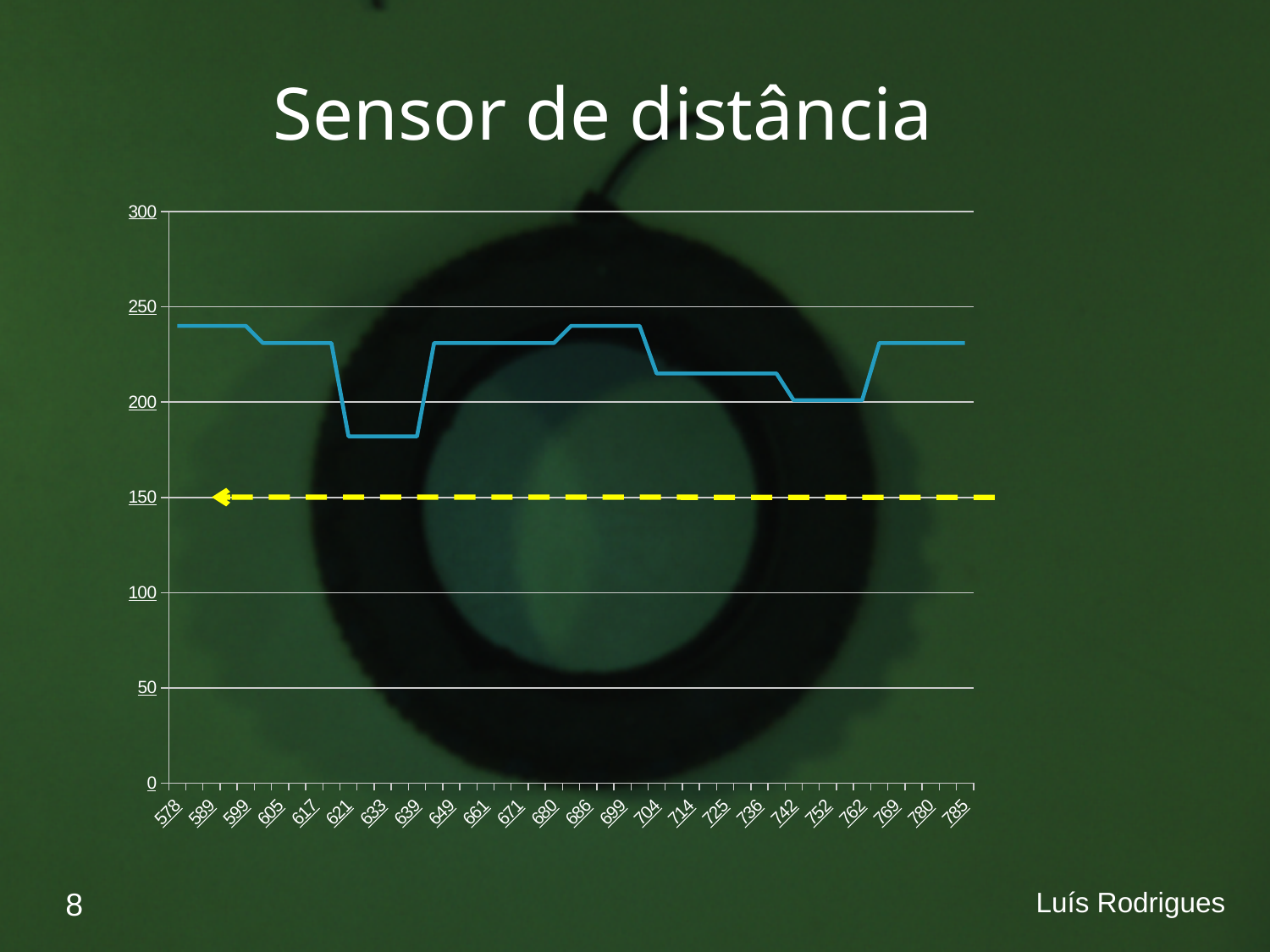
At what value on the y axis is the yellow dashed horizontal line drawn? 150 Which has the larger value, x = 649 or x = 633? 649 Do the values rise or fall between x = 599 and x = 621? fall Is the value at x = 633 greater or less than 150? greater Which has the larger value, x = 578 or x = 621? 578 Is the value at x = 578 greater or less than 200? greater What is the title of the slide containing the chart? Sensor de distância Is the value at x = 742 greater or less than 250? less How many labelled points are there along the x axis of the chart? 24 What kind of chart is shown on the slide? line chart